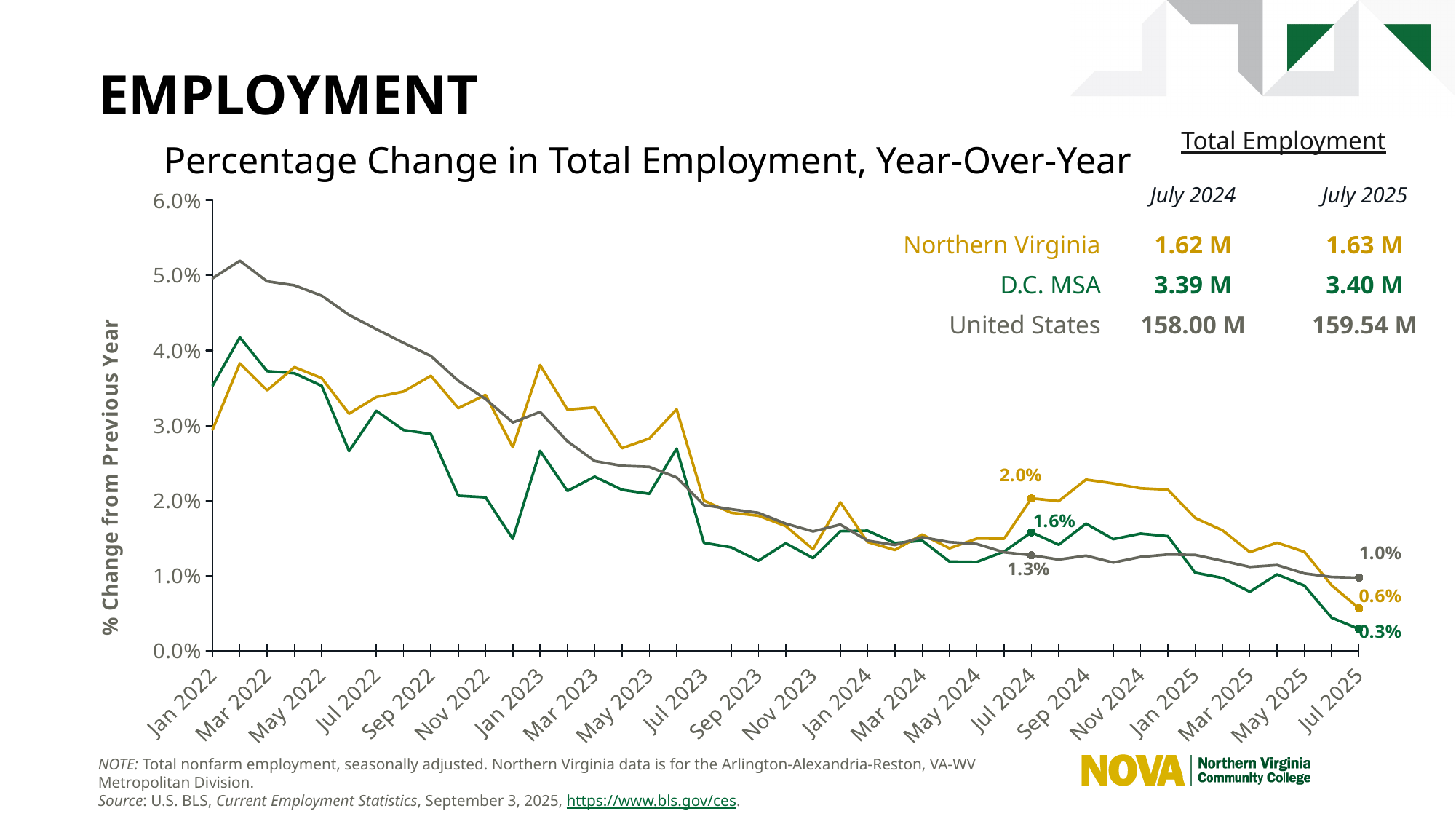
Which series has the lowest year-over-year change in Jul 2025? D.C. MSA Which series has the highest year-over-year change in Jul 2024? Northern Virginia In Jul 2025, which is larger: the year-over-year change for the United States or for Northern Virginia? United States What is the year-over-year percentage change in total employment for the D.C. MSA in Jul 2025? 0.3% What kind of chart is shown on the slide? line chart Overall, does the Northern Virginia line rise or fall from Jan 2022 to Jul 2025? fall What is the year-over-year percentage change in total employment for the United States in Jul 2024? 1.3% By how many percentage points did Northern Virginia's year-over-year change fall from Jul 2024 to Jul 2025? 1.4% Is the United States year-over-year change in Jan 2022 greater or less than 4.0%? greater By how many percentage points did the D.C. MSA's year-over-year change fall from Jul 2024 to Jul 2025? 1.3% What is the year-over-year percentage change in total employment for the United States in Jul 2025? 1.0% What is the year-over-year percentage change in total employment for Northern Virginia in Jul 2024? 2.0%